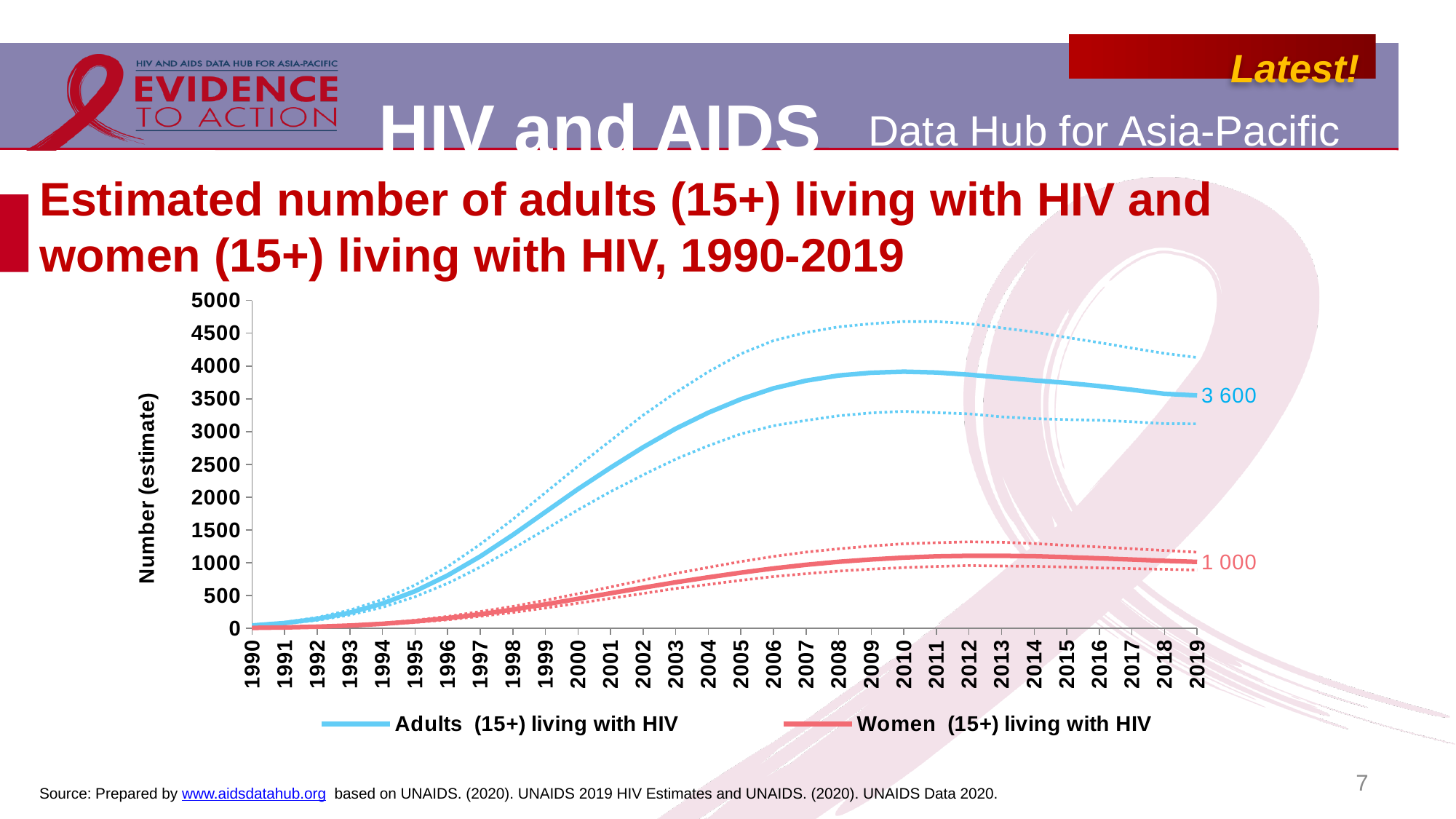
In 2019, which series has the larger value: Adults (15+) living with HIV or Women (15+) living with HIV? Adults (15+) living with HIV What is the value for Women (15+) living with HIV in 2019? 1 000 Is the value for Adults (15+) living with HIV in 2010 greater or less than 3500? greater Is the value for Adults (15+) living with HIV in 2000 greater or less than 1500? greater What kind of chart is shown on the slide? line chart Does the Adults (15+) living with HIV line rise or fall between 1990 and 2010? rise How many series does the legend list? 2 What is the difference between the 2019 values for Adults (15+) living with HIV and Women (15+) living with HIV? 2 600 How many years are shown on the x axis of the chart? 30 What is the title of the y axis? Number (estimate) What is the value for Adults (15+) living with HIV in 2019? 3 600